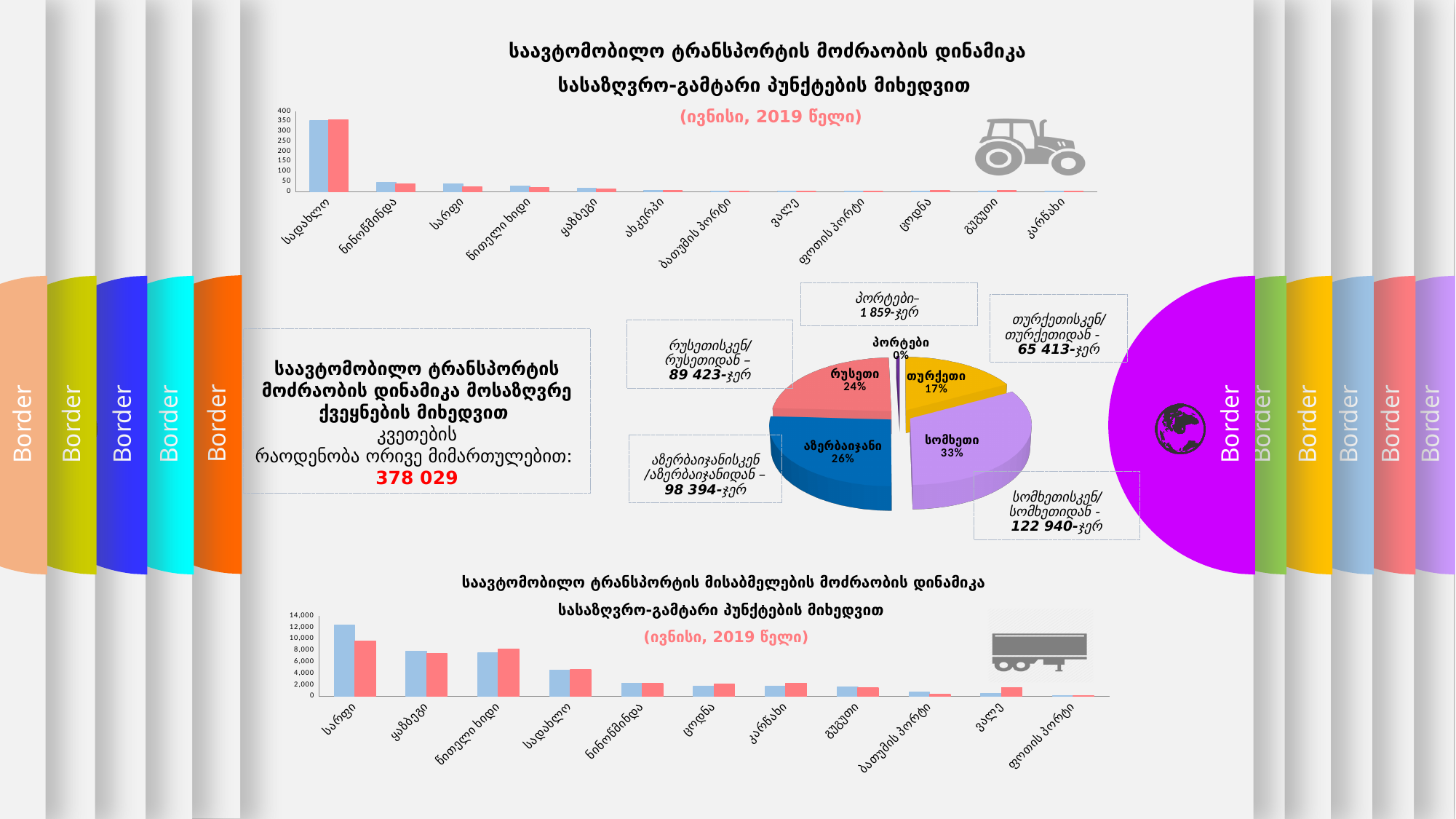
What kind of chart is the chart at the top of the slide? bar chart In the pie chart in the middle of the slide, what share does სომხეთი have? 33% In the chart at the top of the slide, which category has the highest bars? სადახლო In the pie chart in the middle of the slide, what share does რუსეთი have? 24% In the pie chart in the middle of the slide, which slice is the smallest? პორტები In the pie chart in the middle of the slide, how many slices are there? 5 In the pie chart in the middle of the slide, which slice is the largest? სომხეთი In the chart at the bottom of the slide, is the value of the blue bar for სარფი greater or less than 10,000? greater In the pie chart in the middle of the slide, what share does აზერბაიჯანი have? 26% In the chart at the top of the slide, how many categories are shown on the x axis? 12 In the pie chart in the middle of the slide, by how many percentage points does სომხეთი exceed თურქეთი? 16 In the pie chart in the middle of the slide, which is larger: რუსეთი or თურქეთი? რუსეთი